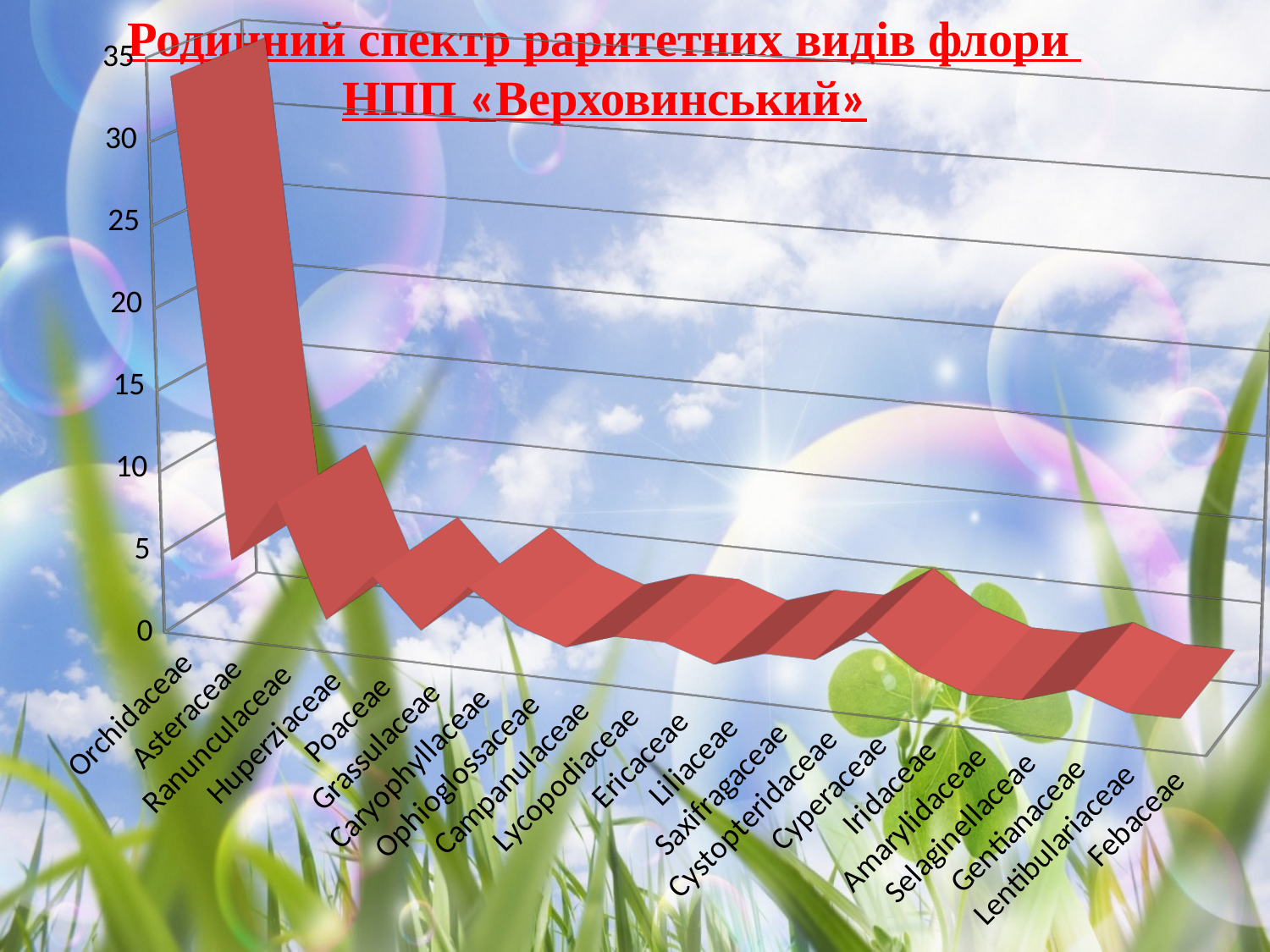
Is the value for Poaceae greater or less than 10? less Is the value for Orchidaceae greater or less than 30? greater What kind of chart is shown on the slide? 3D line chart What is the highest value shown on the vertical axis? 35 Which family has the highest value? Orchidaceae How many plant families (categories) are shown along the x axis? 21 Which is larger, the value for Orchidaceae or the value for Asteraceae? Orchidaceae What is the title of the chart? Родинний спектр раритетних видів флори НПП «Верховинський» Is the value for Asteraceae greater or less than 20? less Do the values generally rise or fall moving from left to right along the x axis? fall